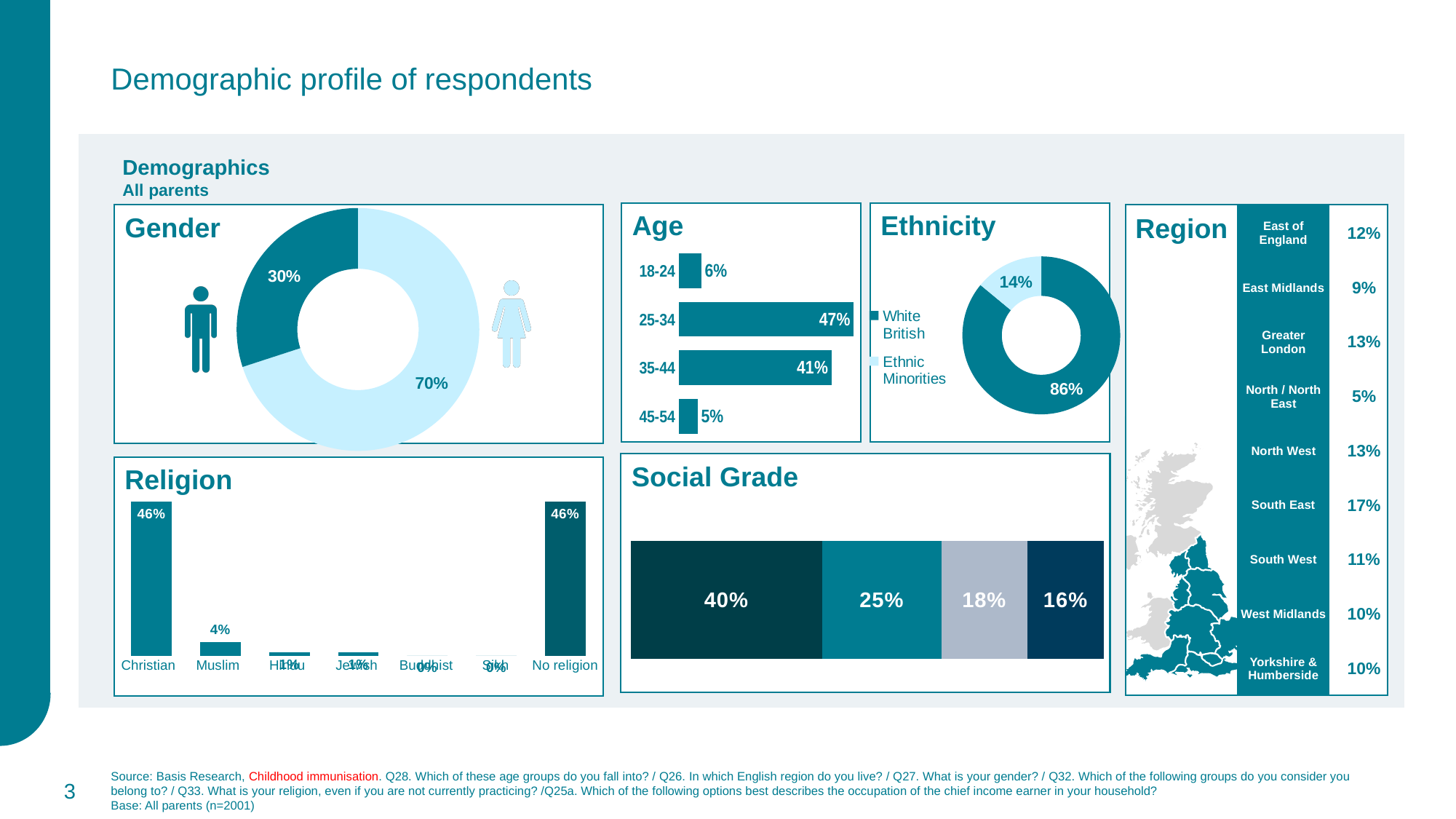
In the Age chart, what is the difference between the 25-34 and 35-44 percentages? 6 percentage points In the Ethnicity chart, what percentage of respondents are White British? 86% In the Ethnicity chart, how many entries does the legend list? 2 In the Gender chart, what is the value of the larger slice? 70% In the Age chart, how many age groups are shown? 4 In the Religion chart, which is larger, Christian or Muslim? Christian In the Social Grade chart, what is the value of the largest segment? 40% What type of chart is the Religion chart? Bar chart In the Age chart, what percentage of respondents are aged 25-34? 47% In the Religion chart, what percentage of respondents are Muslim? 4% What type of chart is the Gender chart? Donut chart In the Age chart, which age group has the lowest percentage? 45-54